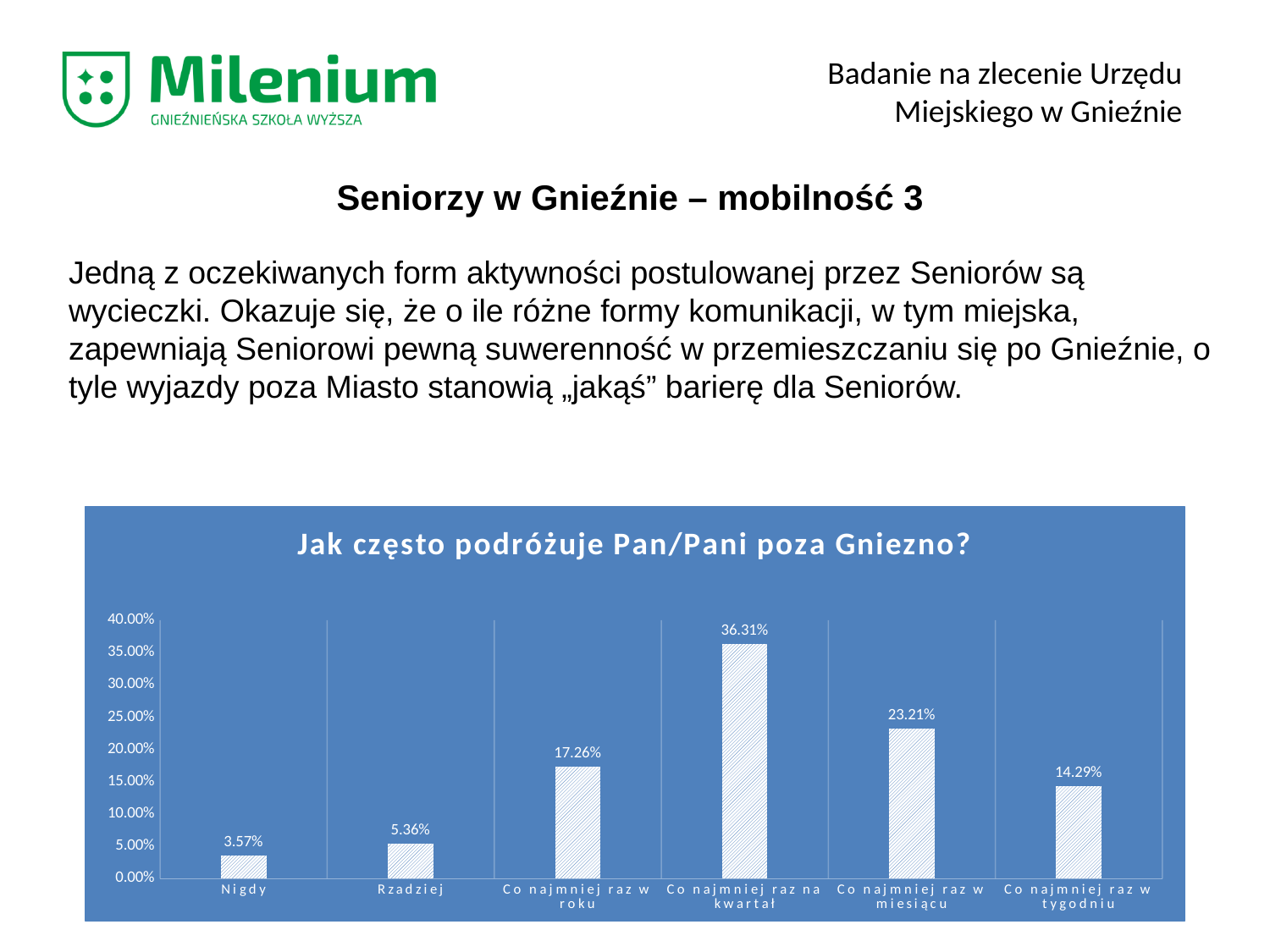
What is the value for "Nigdy"? 3.57% What is the difference between "Rzadziej" and "Nigdy"? 1.79% Which category has the lowest value? Nigdy Which is larger, "Co najmniej raz w roku" or "Co najmniej raz w tygodniu"? Co najmniej raz w roku How many categories are shown on the x axis? 6 What kind of chart is shown on the slide? bar chart Is the value for "Co najmniej raz w miesiącu" greater or less than 20.00%? greater Which category has the highest value? Co najmniej raz na kwartał What is the value for "Co najmniej raz na kwartał"? 36.31% What is the title of the chart? Jak często podróżuje Pan/Pani poza Gniezno? What is the value for "Co najmniej raz w tygodniu"? 14.29% What is the difference between "Co najmniej raz na kwartał" and "Co najmniej raz w miesiącu"? 13.10%